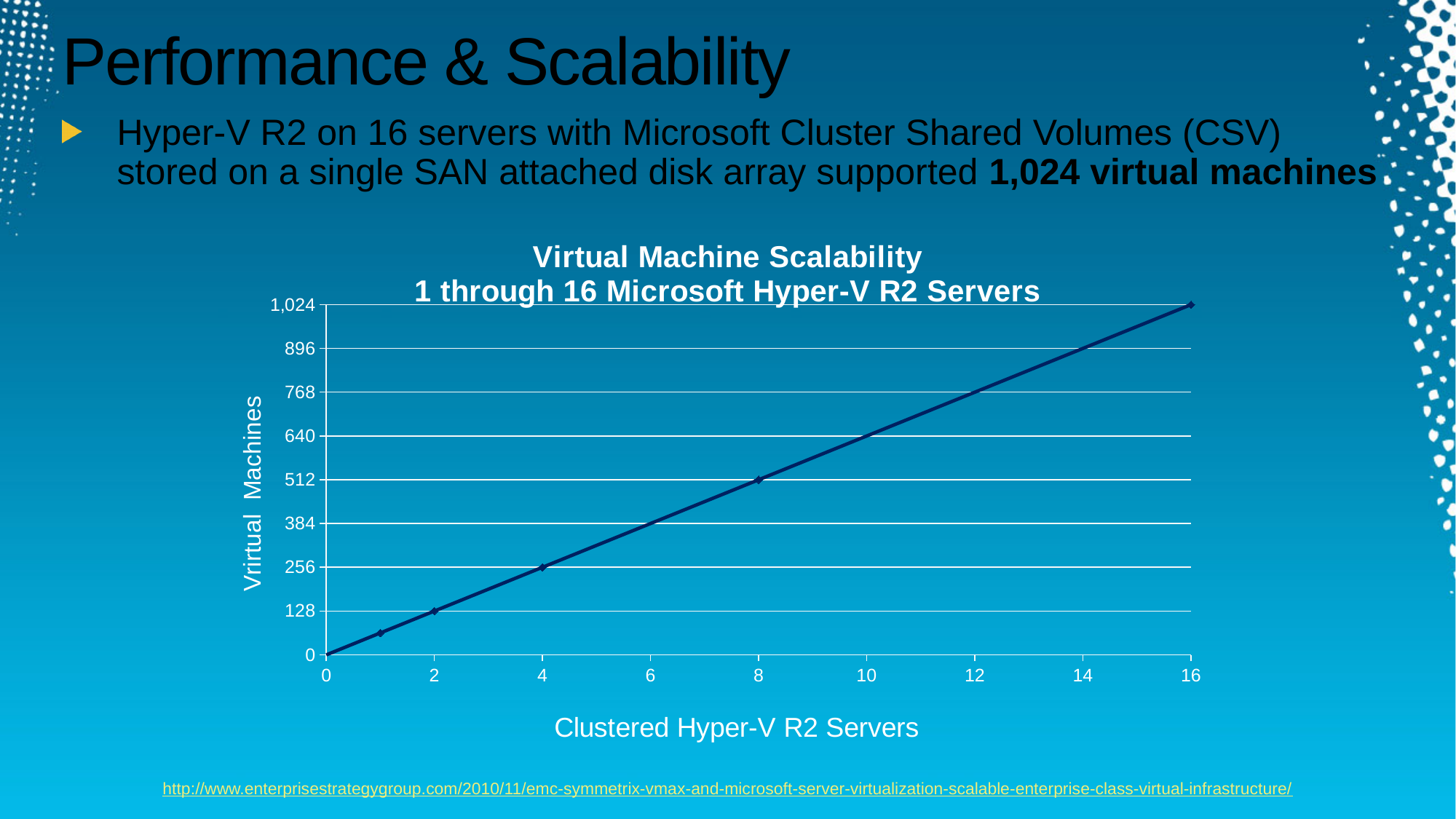
How many virtual machines are supported with 16 clustered Hyper-V R2 servers? 1,024 What is the title of the chart? Virtual Machine Scalability 1 through 16 Microsoft Hyper-V R2 Servers How many virtual machines are supported with 2 clustered Hyper-V R2 servers? 128 What is the difference in virtual machines between 16 servers and 8 servers? 512 What kind of chart is shown on the slide? line chart Do the virtual machine values rise or fall as the number of clustered servers increases? rise Which supports more virtual machines, 8 servers or 4 servers? 8 servers At which number of clustered servers is the virtual machine count highest? 16 Is the number of virtual machines for 1 server greater or less than 128? less How many virtual machines are supported with 8 clustered Hyper-V R2 servers? 512 What is the label of the x axis? Clustered Hyper-V R2 Servers How many virtual machines are supported with 4 clustered Hyper-V R2 servers? 256